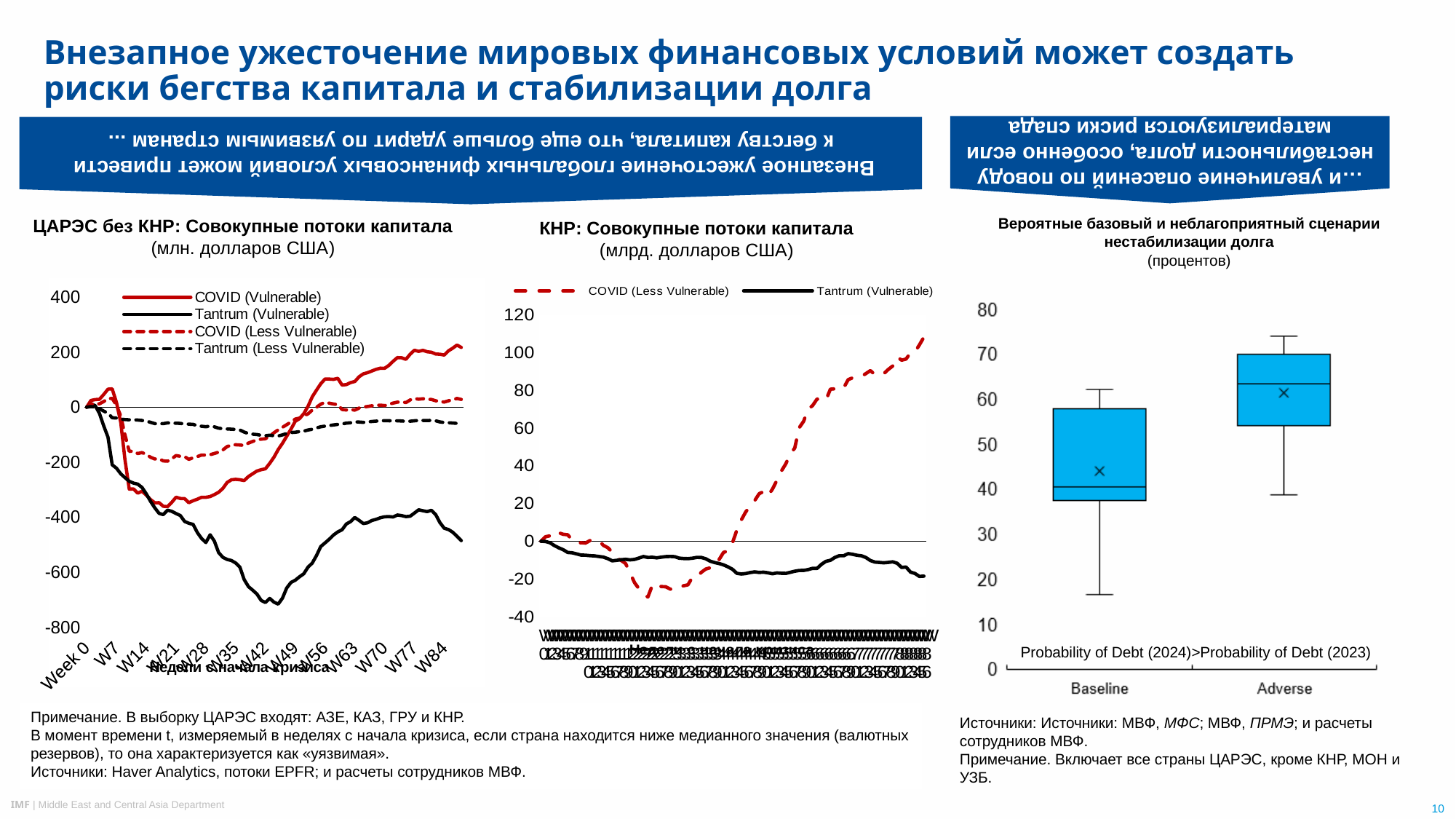
What is the x-axis label of the chart "ЦАРЭС без КНР: Совокупные потоки капитала"? Недели с начала кризиса In the chart "ЦАРЭС без КНР: Совокупные потоки капитала", is the lowest value of the Tantrum (Vulnerable) series greater or less than -600? less In the chart "КНР: Совокупные потоки капитала", is the final value of the COVID (Less Vulnerable) series greater or less than 80? greater In the chart "Вероятные базовый и неблагоприятный сценарии нестабилизации долга", is the median of the Baseline scenario greater or less than 50? less In the chart "Вероятные базовый и неблагоприятный сценарии нестабилизации долга", which scenario has the higher median: Baseline or Adverse? Adverse In the chart "КНР: Совокупные потоки капитала", does the COVID (Less Vulnerable) series rise or fall from the start to the end of the period? Rise How many series does the legend of the chart "ЦАРЭС без КНР: Совокупные потоки капитала" list? 4 How many series does the legend of the chart "КНР: Совокупные потоки капитала" list? 2 What kind of chart is the chart titled "Вероятные базовый и неблагоприятный сценарии нестабилизации долга"? Box plot What kind of chart is the chart titled "ЦАРЭС без КНР: Совокупные потоки капитала"? Line chart How many scenarios are shown on the x axis of the chart "Вероятные базовый и неблагоприятный сценарии нестабилизации долга"? 2 In the chart "ЦАРЭС без КНР: Совокупные потоки капитала", which series is higher at the end of the period: COVID (Vulnerable) or Tantrum (Vulnerable)? COVID (Vulnerable)